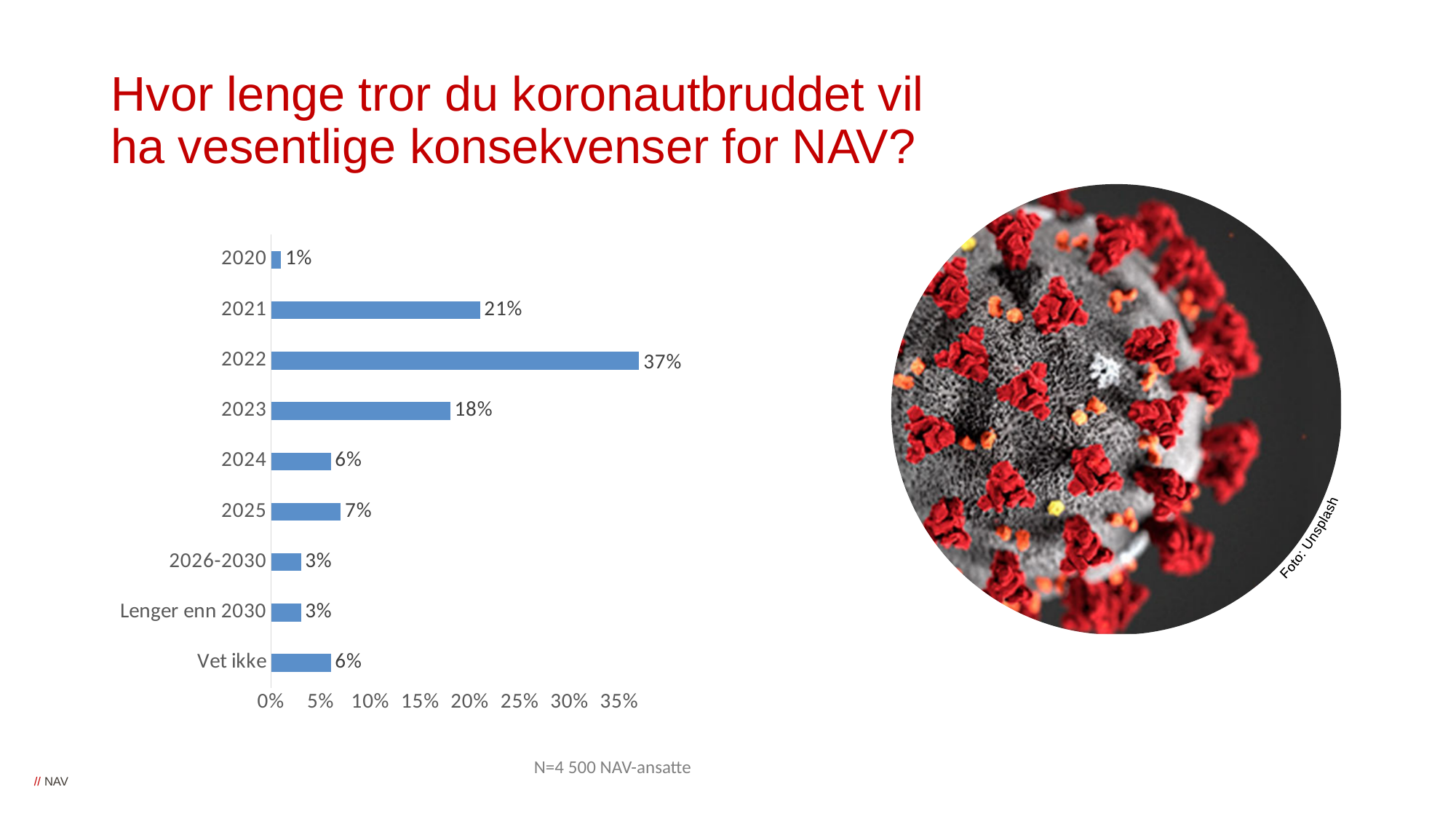
Which category has the highest value? 2022 What is the sample size noted below the chart? N=4 500 NAV-ansatte What is the value for 'Vet ikke'? 6% What is the difference between the values for 2021 and 2020? 20% What is the value for 'Lenger enn 2030'? 3% How many categories are shown on the chart? 9 Which is larger, the value for 2024 or the value for 2025? 2025 What percentage of respondents answered 2022? 37% What is the value for 2021? 21% What is the difference between the values for 2022 and 2023? 19% Which category has the lowest value? 2020 What kind of chart is shown on the slide? Bar chart